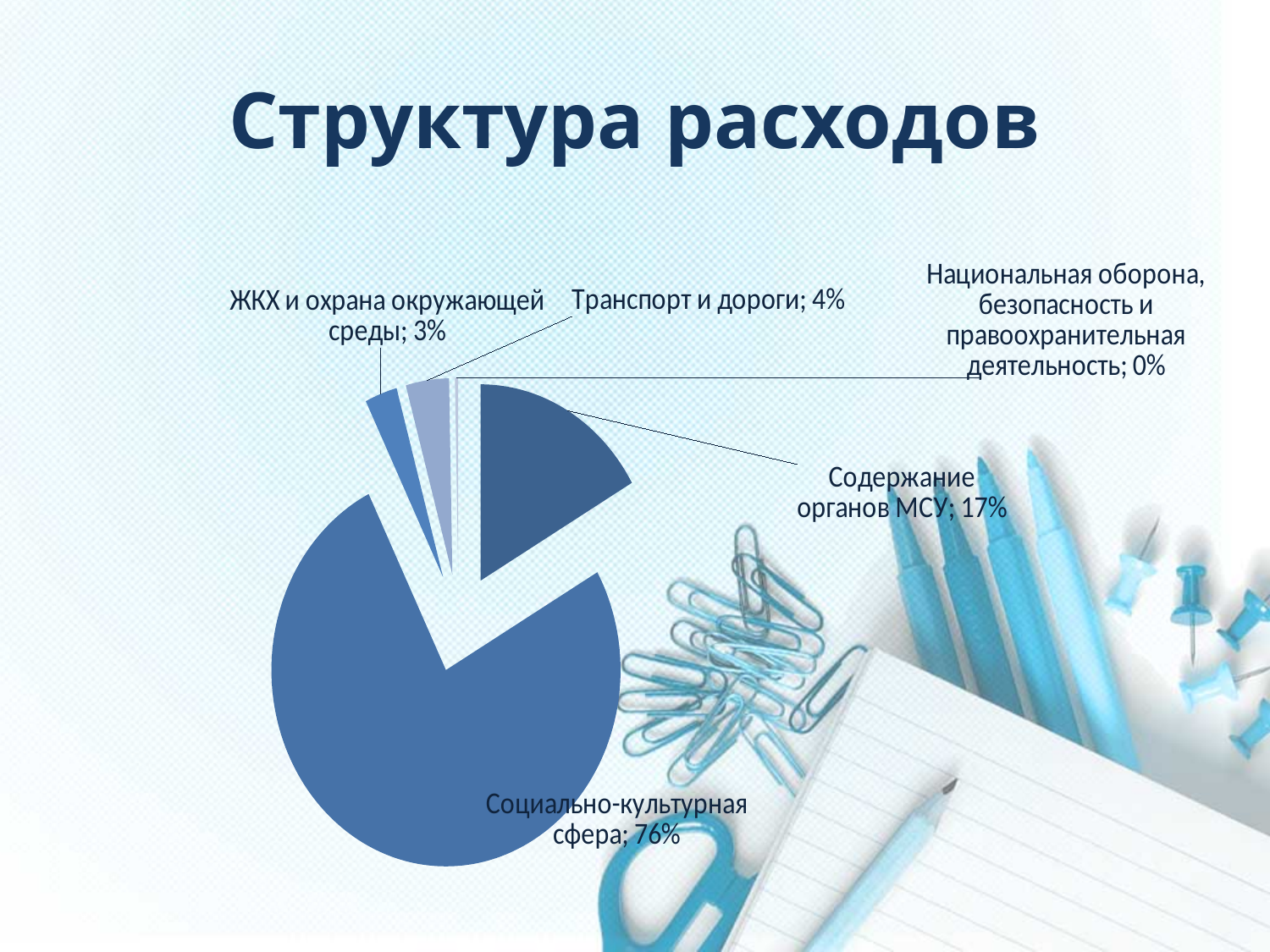
How many categories are shown in the pie chart? 5 Which category has the largest share of expenses? Социально-культурная сфера What share of expenses goes to Содержание органов МСУ? 17% What share of expenses goes to Национальная оборона, безопасность и правоохранительная деятельность? 0% Which category has the smallest share of expenses? Национальная оборона, безопасность и правоохранительная деятельность What is the difference in percentage points between Социально-культурная сфера and Содержание органов МСУ? 59 Which is larger: the share for Транспорт и дороги or the share for ЖКХ и охрана окружающей среды? Транспорт и дороги What type of chart is shown on the slide? Pie chart What share of expenses goes to Транспорт и дороги? 4% What share of expenses goes to ЖКХ и охрана окружающей среды? 3% What share of expenses goes to Социально-культурная сфера? 76% What is the title of the chart on the slide? Структура расходов